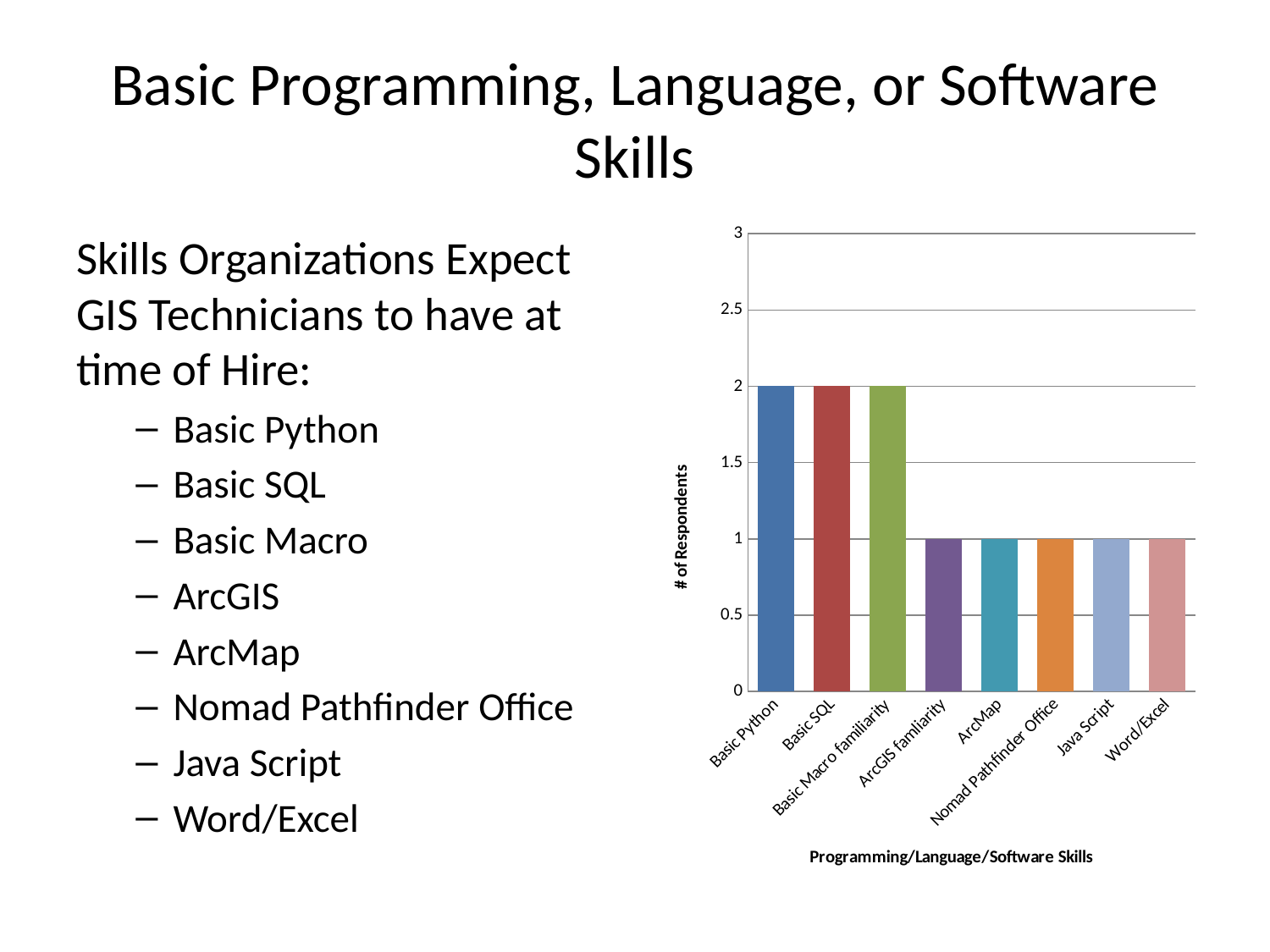
What is the value for ArcMap in the chart? 1 What is the value for Nomad Pathfinder Office in the chart? 1 What is the value for Basic SQL in the chart? 2 Is the value for Basic Python greater or less than 1.5? greater Which is larger in the chart, the value for Basic Macro familiarity or the value for Java Script? Basic Macro familiarity What is the value for Basic Python in the chart? 2 What type of chart is shown on the slide? bar chart What is the label of the vertical axis of the chart? # of Respondents What is the value for Word/Excel in the chart? 1 What is the label of the horizontal axis of the chart? Programming/Language/Software Skills How many categories are plotted on the x axis of the chart? 8 What is the difference between the value for Basic SQL and the value for ArcGIS familiarity? 1